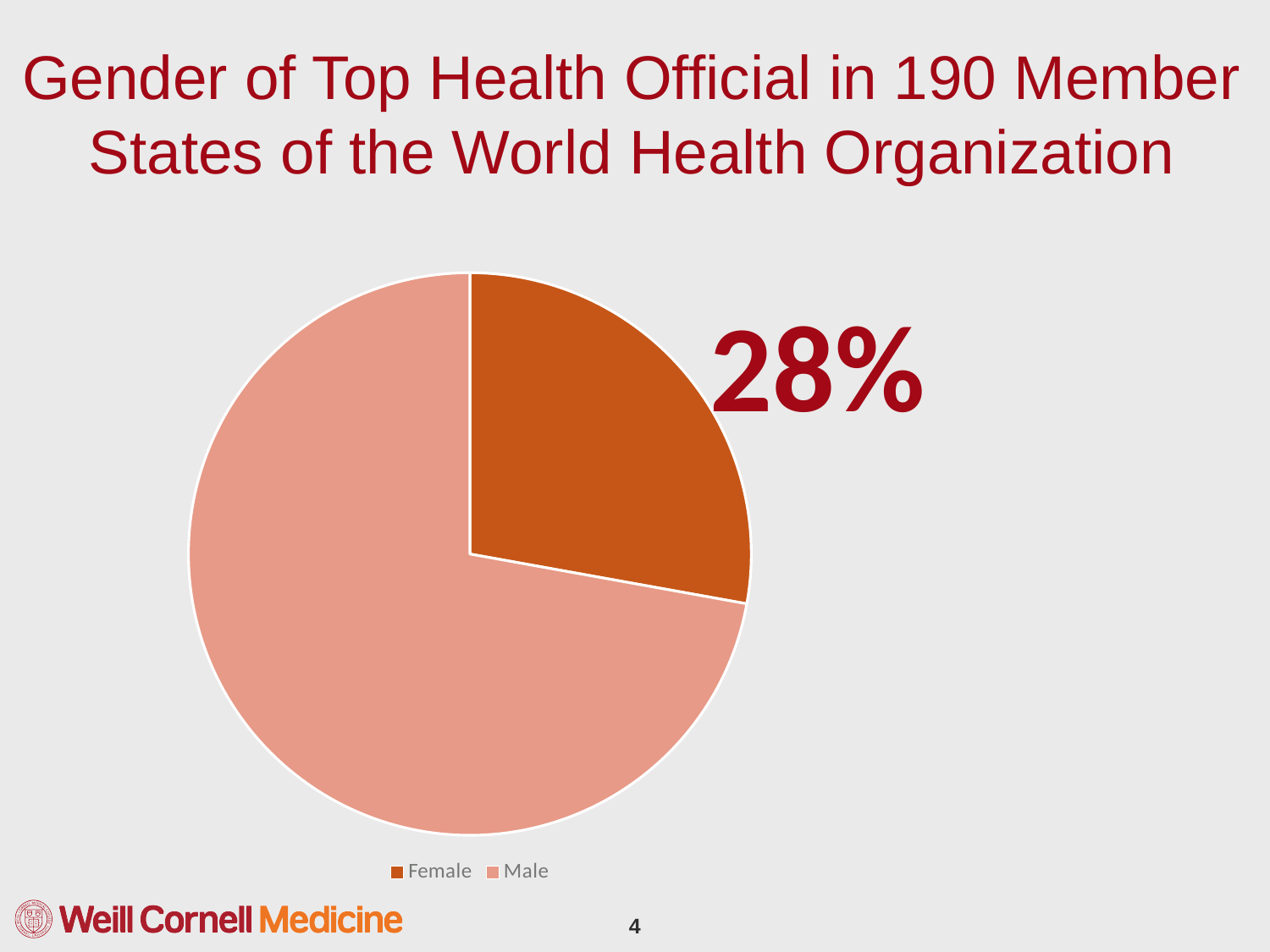
Which slice is larger, Female or Male? Male Is the Female share of the pie greater or less than 50%? less Which category has the smallest slice of the pie? Female How many entries does the legend list? 2 What is the title of the slide containing the pie chart? Gender of Top Health Official in 190 Member States of the World Health Organization What percentage of the pie is the Female slice? 28% What kind of chart is shown on the slide? pie chart What share of the pie does the Female slice represent? 28% Which category has the largest slice of the pie? Male Is the Male share of the pie greater or less than 50%? greater How many slices does the pie chart have? 2 Which legend entry is shown in the darker orange colour? Female